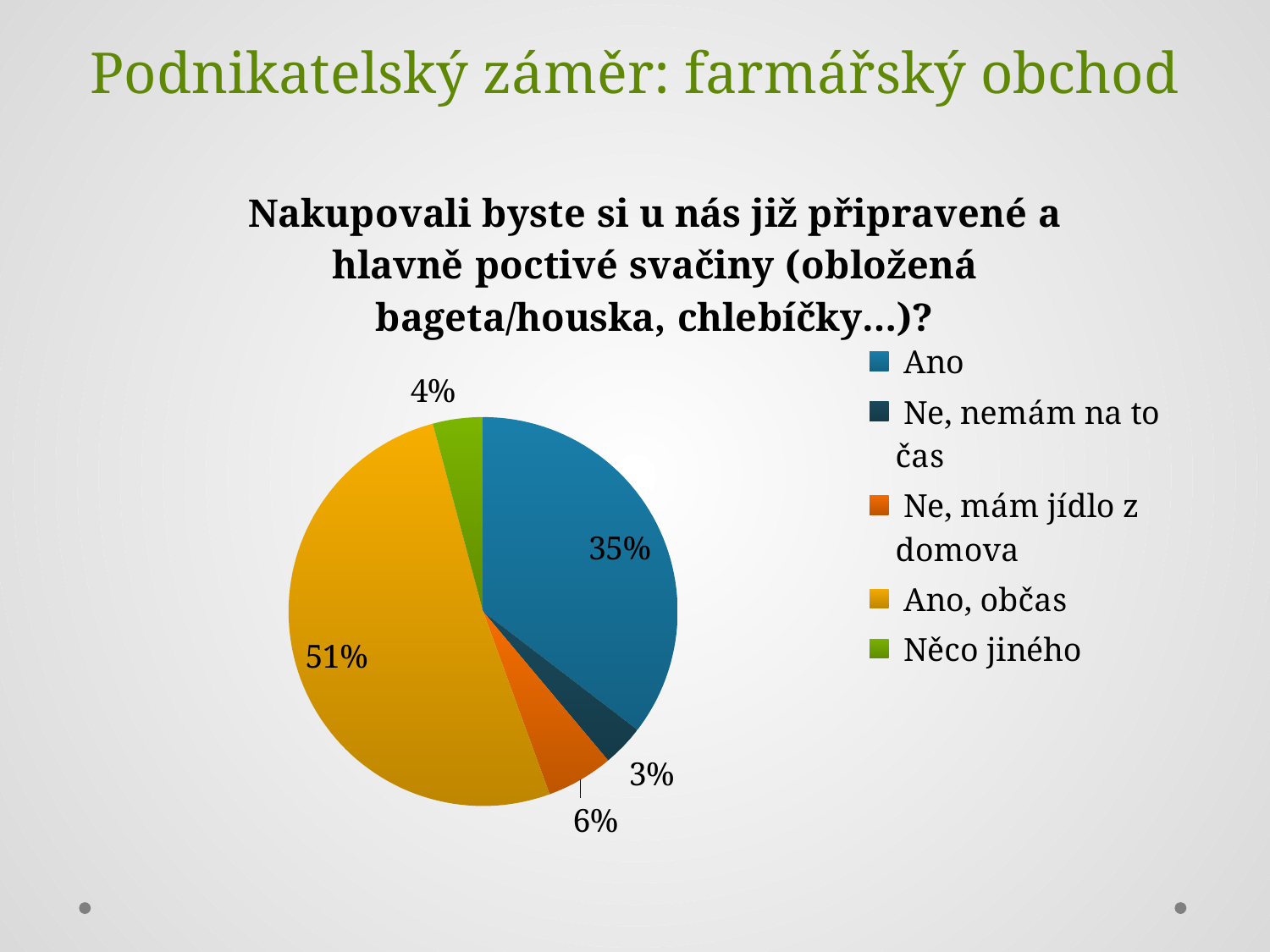
Which category has the largest slice of the pie? Ano, občas Which category has the smallest slice of the pie? Ne, nemám na to čas Which is larger, the slice for "Ne, mám jídlo z domova" or the slice for "Něco jiného"? Ne, mám jídlo z domova What colour is the slice for "Ano, občas"? Yellow/orange What share of the pie does "Ne, mám jídlo z domova" have? 6% What share of the pie does "Ano, občas" have? 51% What share of the pie does "Ano" have? 35% What is the difference in percentage points between "Ano, občas" and "Ano"? 16 What kind of chart is shown on the slide? Pie chart What share of the pie does "Něco jiného" have? 4% How many categories does the pie chart show? 5 What share of the pie does "Ne, nemám na to čas" have? 3%